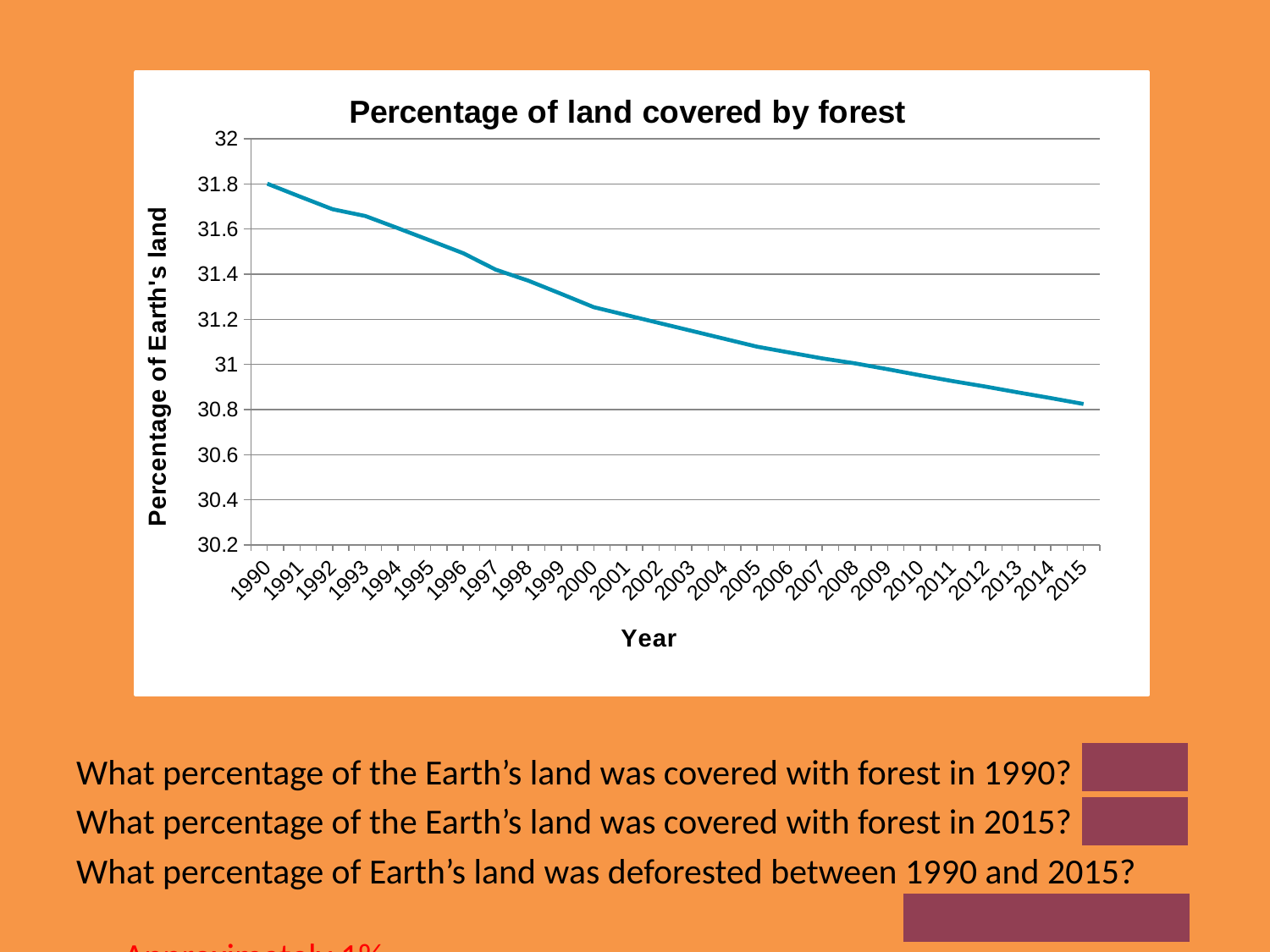
What is the percentage of land covered by forest in 1990? 31.8 How many years are plotted on the x axis? 26 What kind of chart is shown on the slide? line chart Which year has a larger value, 1993 or 2003? 1993 Do the values rise or fall from 1990 to 2015? fall Is the value for 2015 greater or less than 31? less Is the value for 1995 greater or less than 31.4? greater Is the value for 2012 greater or less than 31? less Which year has the highest percentage of land covered by forest? 1990 What is the title of the chart? Percentage of land covered by forest What is the label on the vertical axis of the chart? Percentage of Earth's land Which year has the lowest percentage of land covered by forest? 2015